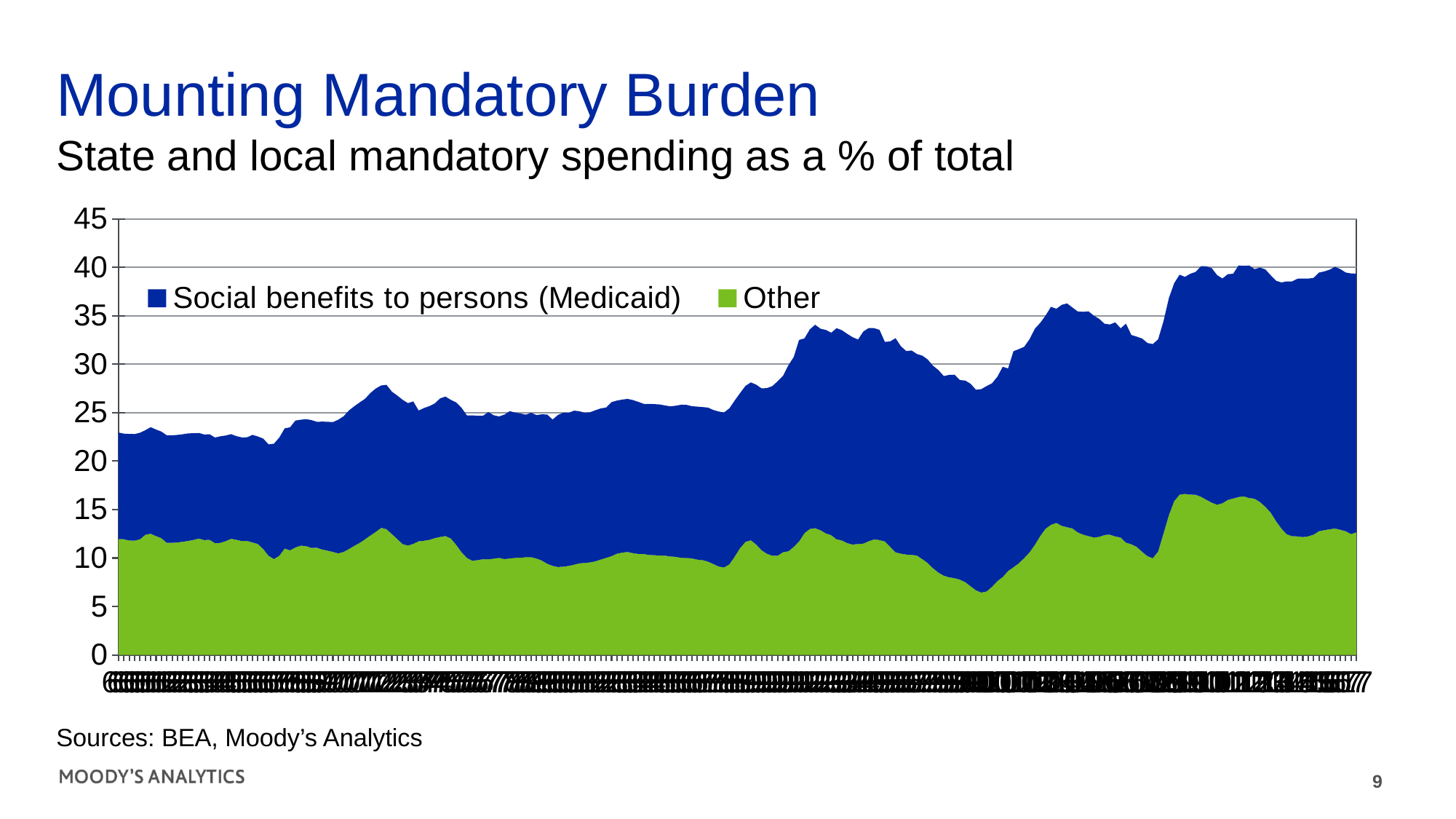
What is the highest value shown on the vertical axis? 45 Is the highest point reached by the total stacked value greater or less than 35? greater What are the two series named in the legend? Social benefits to persons (Medicaid) and Other What kind of chart is shown on the slide? Stacked area chart Does the total stacked value rise or fall overall from the left end of the chart to the right end? Rise How many series does the legend list? 2 Is the value of the Other series at the far right of the chart greater or less than 10? greater Which series is shown in green? Other Is the total stacked value at the far right of the chart greater or less than 35? greater At the far right of the chart, which series accounts for the larger share: Social benefits to persons (Medicaid) or Other? Social benefits to persons (Medicaid)